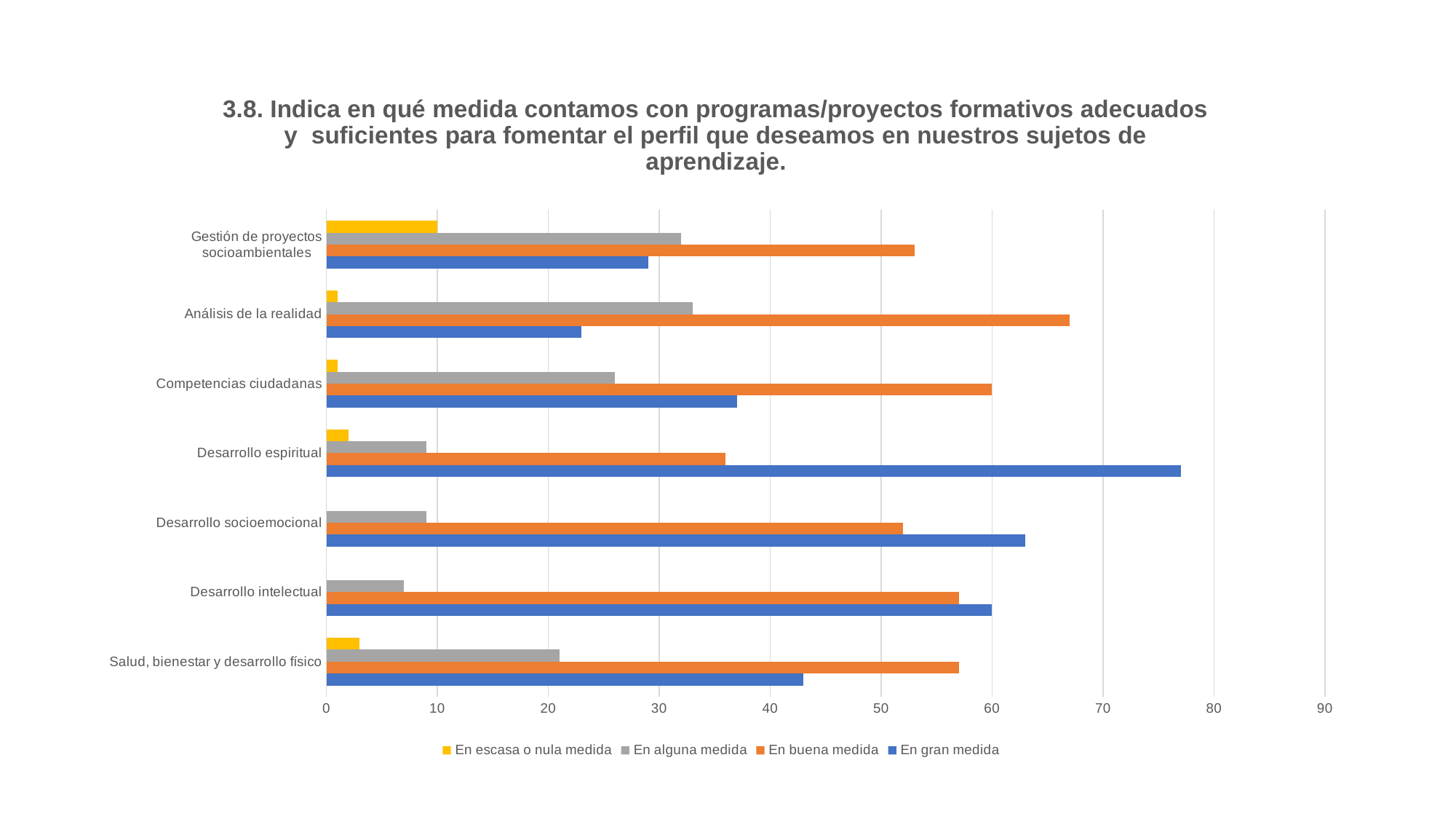
Is the 'En gran medida' value for Análisis de la realidad greater or less than 30? less For Desarrollo socioemocional, which is larger: 'En gran medida' or 'En buena medida'? En gran medida Is the 'En buena medida' value for Competencias ciudadanas greater or less than 50? greater Is the 'En gran medida' value for Desarrollo espiritual greater or less than 70? greater Which series is shown in yellow in the legend? En escasa o nula medida For Gestión de proyectos socioambientales, which is larger: 'En buena medida' or 'En gran medida'? En buena medida Which category has the highest value for 'En gran medida'? Desarrollo espiritual What kind of chart is shown on the slide? Bar chart How many categories are plotted on the vertical axis of the chart? 7 How many series does the legend list? 4 Which category has the highest value for 'En buena medida'? Análisis de la realidad